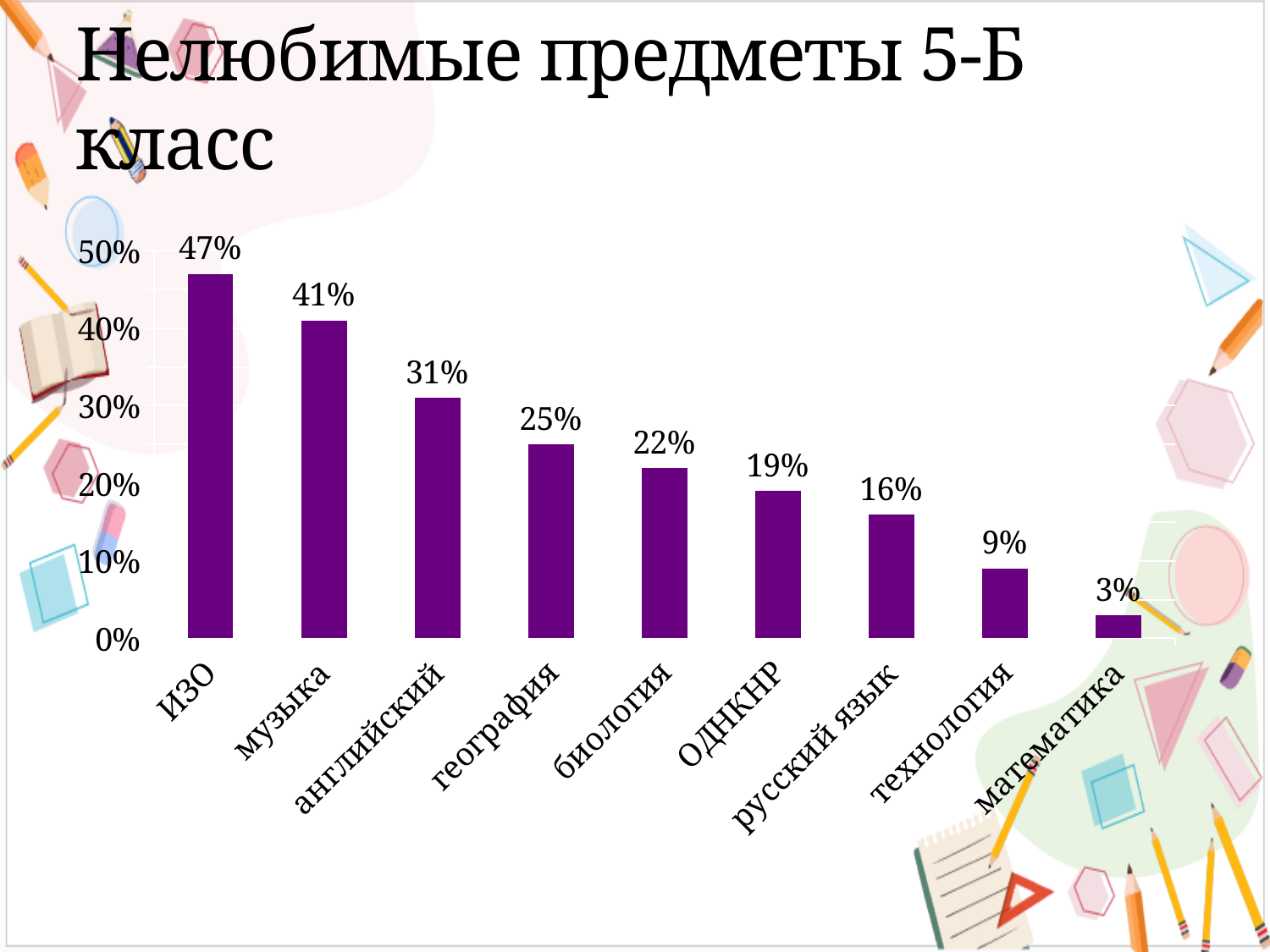
Which is larger, the value for биология or the value for ОДНКНР? биология Which category has the highest value? ИЗО What is the value for ИЗО? 47% What is the value for русский язык? 16% Which category has the lowest value? математика Do the values rise or fall from left to right along the x axis? fall How many categories are shown on the chart? 9 Is the value for технология greater or less than 10%? less What is the title of the slide? Нелюбимые предметы 5-Б класс What is the difference between the values for музыка and английский? 10% What is the value for география? 25% What kind of chart is shown on the slide? bar chart